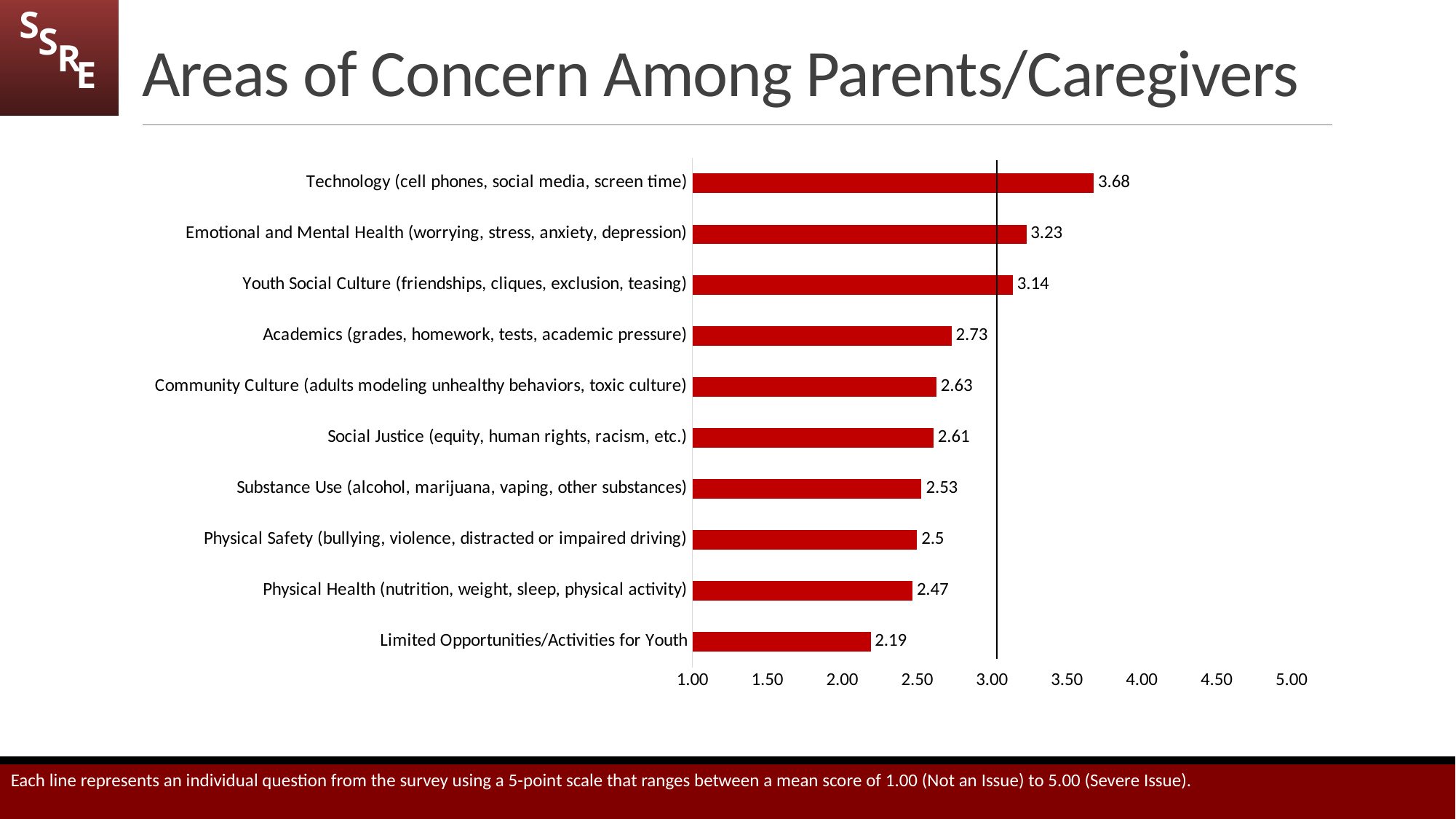
What kind of chart is shown on the slide? Bar chart What is the difference between the mean scores for Physical Health and Limited Opportunities/Activities for Youth? 0.28 What is the mean score for Academics (grades, homework, tests, academic pressure)? 2.73 What is the title of the slide? Areas of Concern Among Parents/Caregivers What is the difference between the mean scores for Technology and Emotional and Mental Health? 0.45 Which has a higher mean score, Youth Social Culture or Academics? Youth Social Culture What is the mean score for Physical Safety (bullying, violence, distracted or impaired driving)? 2.5 Which area of concern has the lowest mean score? Limited Opportunities/Activities for Youth How many areas of concern are shown in the chart? 10 Which area of concern has the highest mean score? Technology (cell phones, social media, screen time) What is the mean score for Technology (cell phones, social media, screen time)? 3.68 Is the value for Substance Use greater or less than 3.00? less